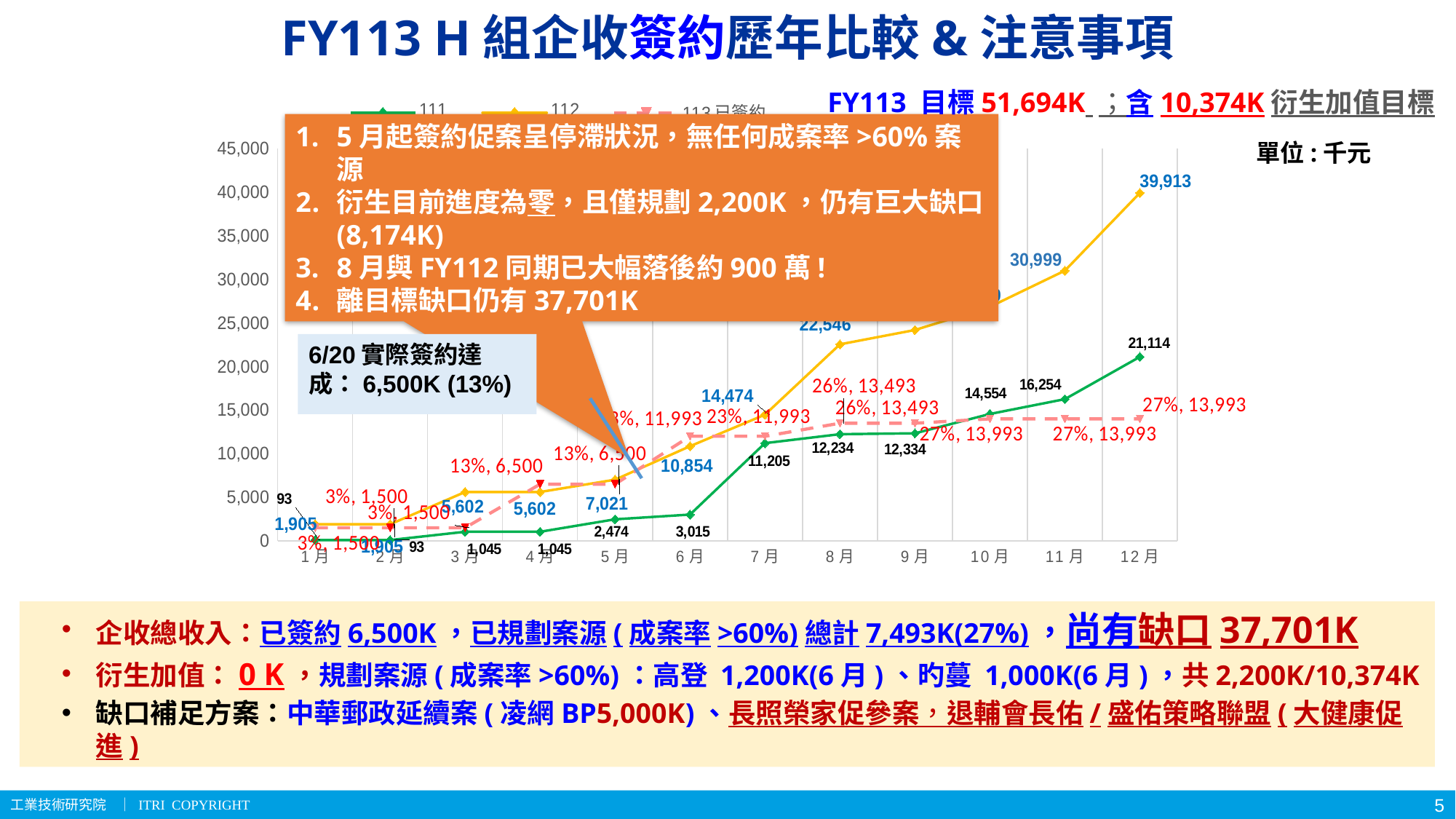
What is the value of the 112 series at 11月? 30,999 In which month does the 112 series reach its highest value? 12月 What is the value of the 111 series at 10月? 14,554 What kind of chart is shown on the slide? line chart How many months are shown along the x axis of the chart? 12 What is the value of the 112 series at 8月? 22,546 At 11月, which series has the larger value, 111 or 112? 112 Is the value of the 112 series at 9月 greater or less than 20,000? greater What is the value of the 112 series at 12月? 39,913 What is the value of the 111 series at 12月? 21,114 What is the difference between the 112 and 111 series values at 12月? 18,799